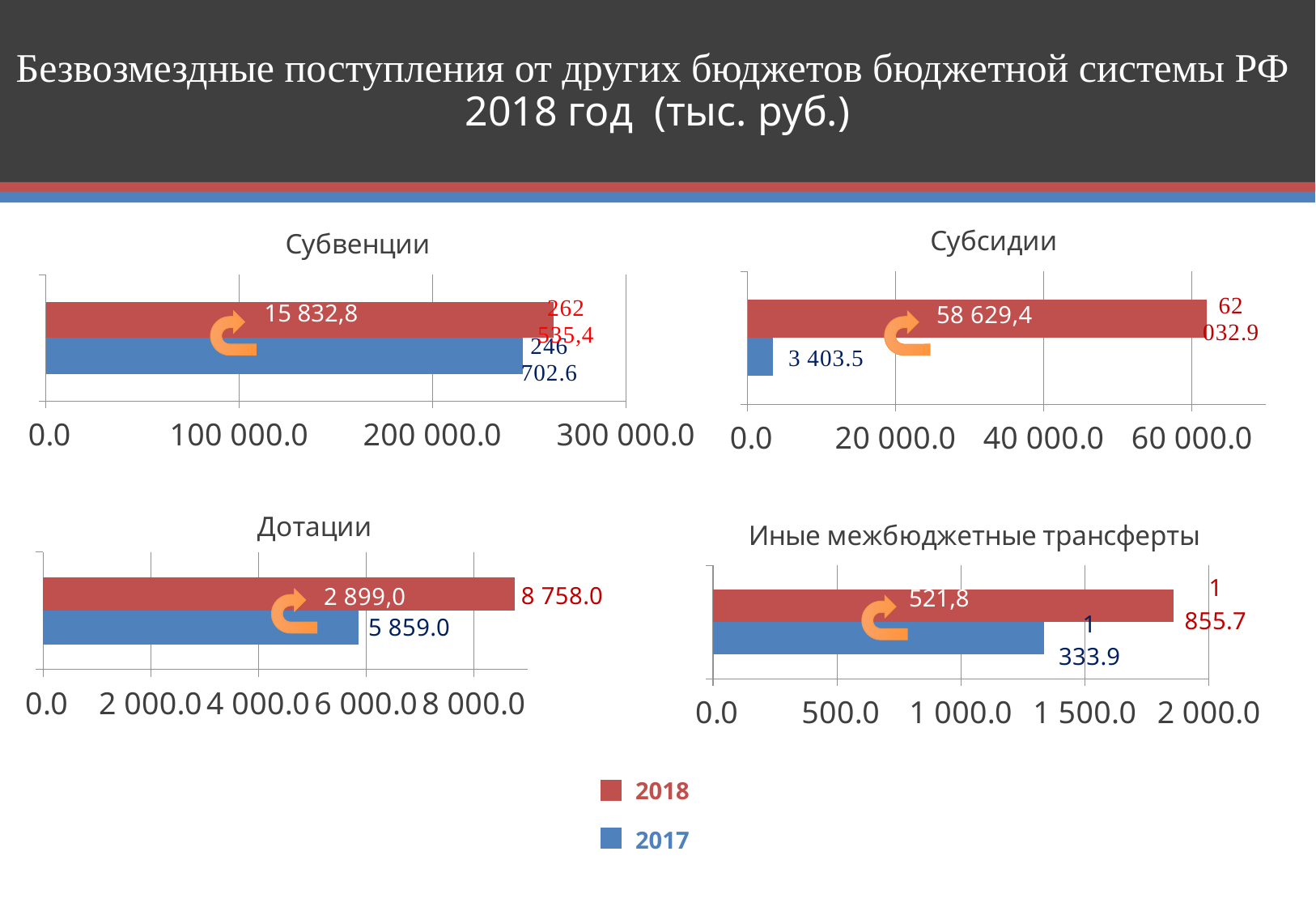
In the Дотации chart, what is the value for 2018? 8 758.0 What kind of chart is the Дотации chart? bar chart Which colour represents 2017 in the charts? blue In the Субсидии chart, which year has the larger value, 2018 or 2017? 2018 In the Субвенции chart, what is the value for 2017? 246 702.6 In the Субсидии chart, what is the value for 2017? 3 403.5 In the Дотации chart, what is the difference between the 2018 and 2017 values? 2 899,0 In the Субсидии chart, what is the value for 2018? 62 032.9 In the Иные межбюджетные трансферты chart, is the value for 2018 greater or less than 1 500.0? greater How many series does the legend list? 2 In the Иные межбюджетные трансферты chart, what is the value for 2017? 1 333.9 In the Субвенции chart, what is the value for 2018? 262 535,4